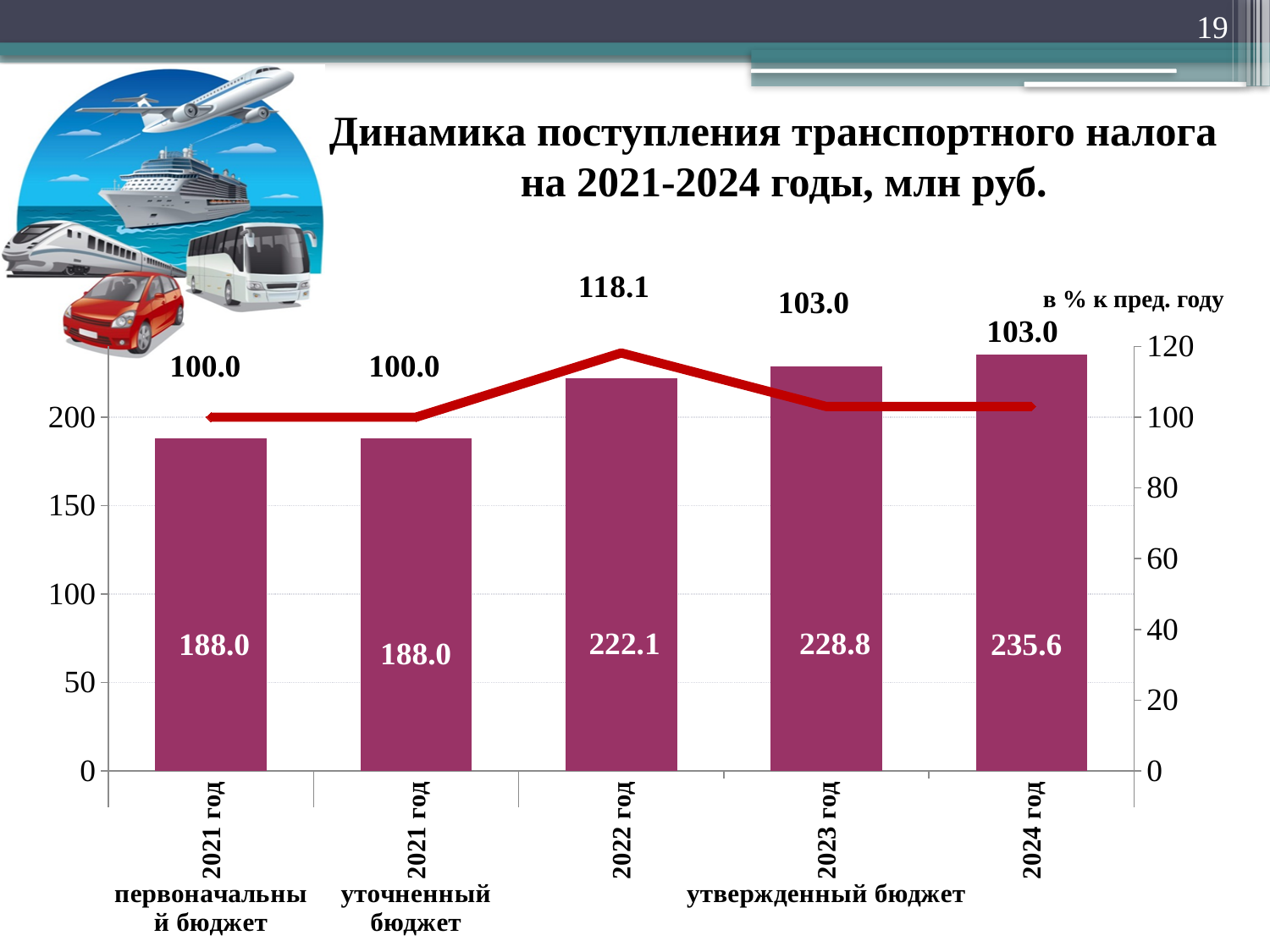
How many bars are shown in the chart? 5 What is the transport tax revenue (bar value) for 2024 год? 235.6 What is the line value (в % к пред. году) for 2023 год? 103.0 Which year has the highest value on the line (в % к пред. году)? 2022 год What is the bar value for 2021 год (уточненный бюджет)? 188.0 What is the bar value for 2022 год? 222.1 What is the difference between the bar values for 2022 год and 2021 год (первоначальный бюджет)? 34.1 Which year has the highest bar value? 2024 год What is the difference between the bar values for 2024 год and 2023 год? 6.8 What is the line value (в % к пред. году) for 2022 год? 118.1 What is the title of the chart? Динамика поступления транспортного налога на 2021-2024 годы, млн руб. Which is larger, the bar value for 2023 год or for 2022 год? 2023 год